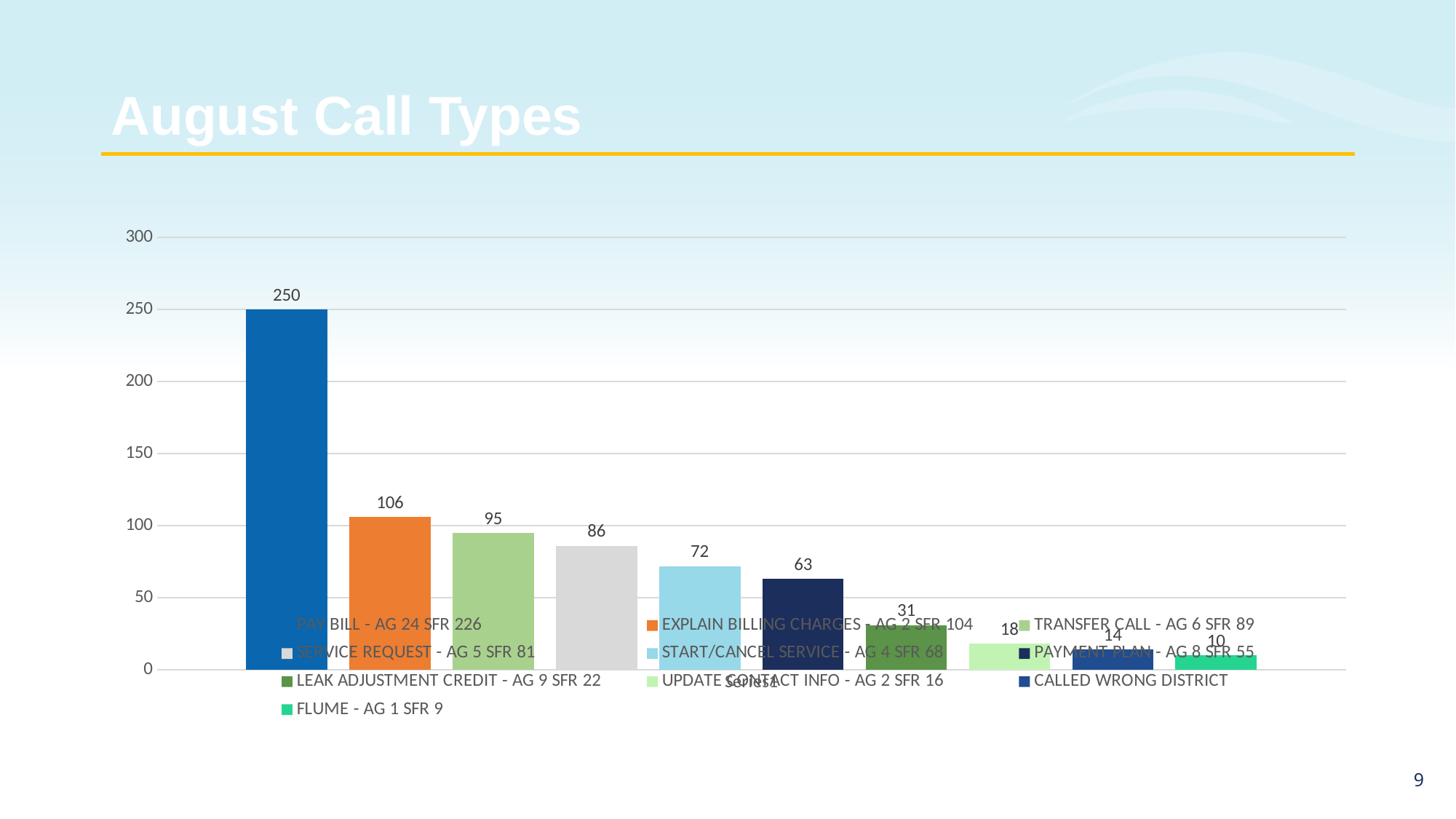
What is the value of the FLUME bar? 10 How many bars are plotted in the chart? 10 Which call type has the lowest value? FLUME What is the value of the START/CANCEL SERVICE bar? 72 Is the value for PAYMENT PLAN greater or less than 50? greater What is the value of the PAY BILL bar? 250 Which call type has the highest value? PAY BILL Which is larger, the TRANSFER CALL value or the SERVICE REQUEST value? TRANSFER CALL What is the title of the slide? August Call Types What is the value of the EXPLAIN BILLING CHARGES bar? 106 What kind of chart is shown on the slide? Bar chart What is the difference between the PAY BILL value and the EXPLAIN BILLING CHARGES value? 144